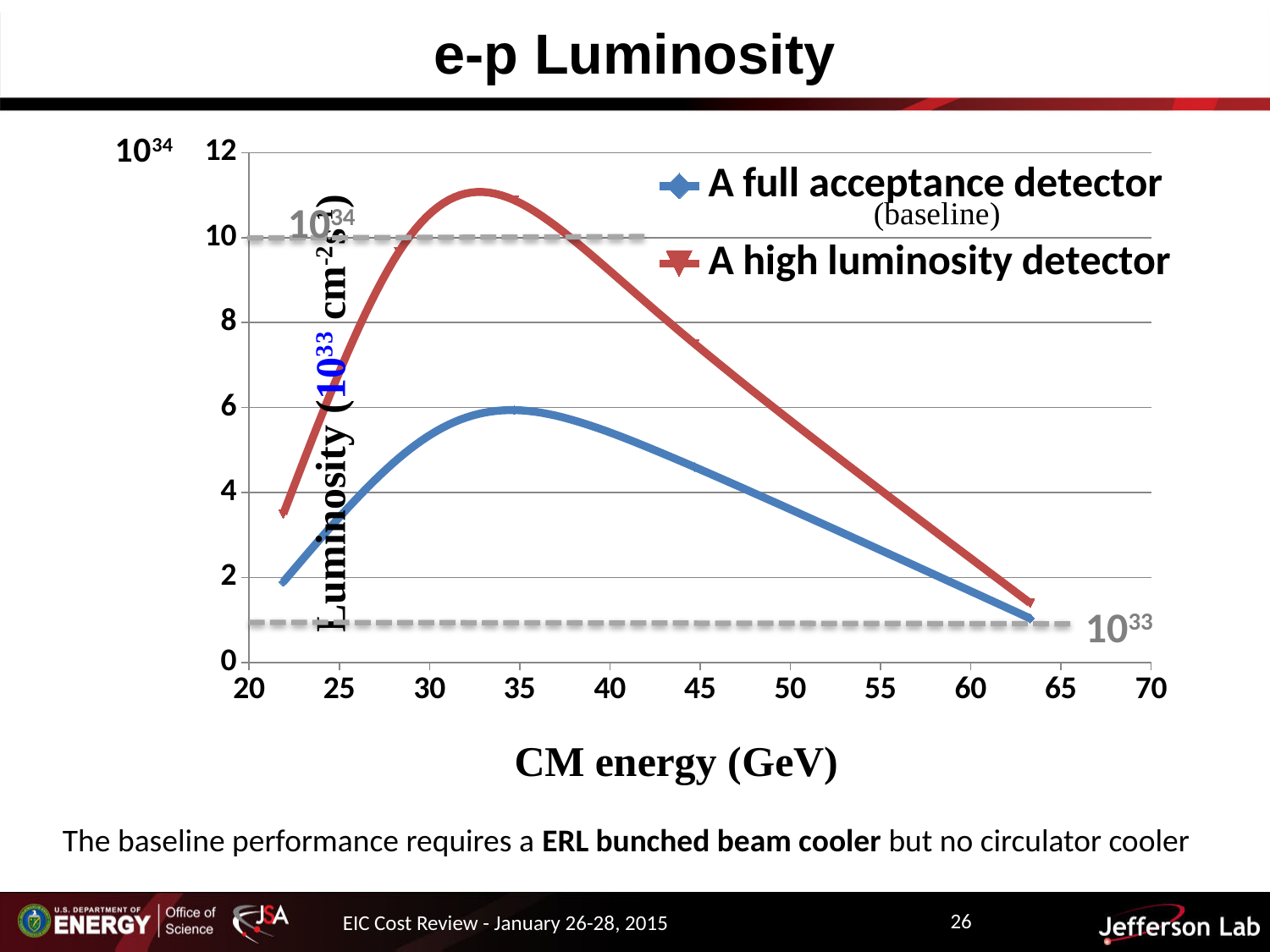
What is the title of the x axis? CM energy (GeV) What kind of chart is shown on the slide? line chart Is the peak value of the 'A high luminosity detector' curve greater or less than 10? greater Is the peak value of the 'A full acceptance detector' curve greater or less than 8? less Which series reaches the higher maximum luminosity? A high luminosity detector At 40 GeV, which series has the higher luminosity, 'A full acceptance detector' or 'A high luminosity detector'? A high luminosity detector Is the value of the 'A full acceptance detector' curve at 60 GeV greater or less than 4? less How many series does the legend list? 2 Which series is plotted in red? A high luminosity detector Between 40 GeV and 65 GeV, do the luminosity values of the 'A high luminosity detector' curve rise or fall? fall